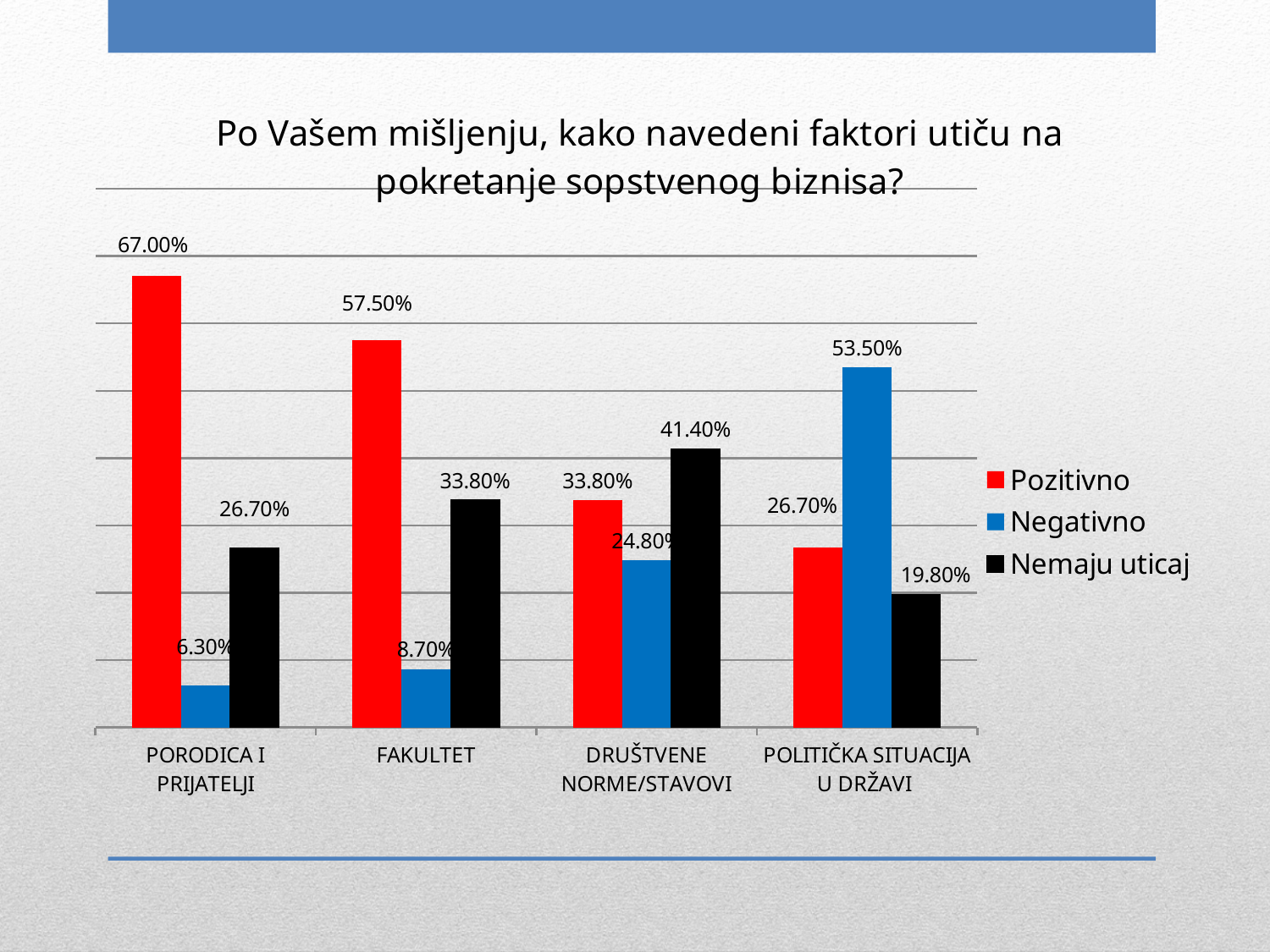
What is the Negativno value for POLITIČKA SITUACIJA U DRŽAVI? 53.50% What kind of chart is shown on the slide? Bar chart How many categories are shown on the x axis? 4 Which category has the highest Pozitivno value? PORODICA I PRIJATELJI Which category has the lowest Negativno value? PORODICA I PRIJATELJI What is the difference between the Pozitivno values for PORODICA I PRIJATELJI and FAKULTET? 9.50% What is the Nemaju uticaj value for DRUŠTVENE NORME/STAVOVI? 41.40% What is the Pozitivno value for PORODICA I PRIJATELJI? 67.00% How many series does the legend list? 3 Which colour represents the Negativno series? Blue What is the Negativno value for FAKULTET? 8.70% Which is larger for DRUŠTVENE NORME/STAVOVI: the Pozitivno value or the Nemaju uticaj value? Nemaju uticaj